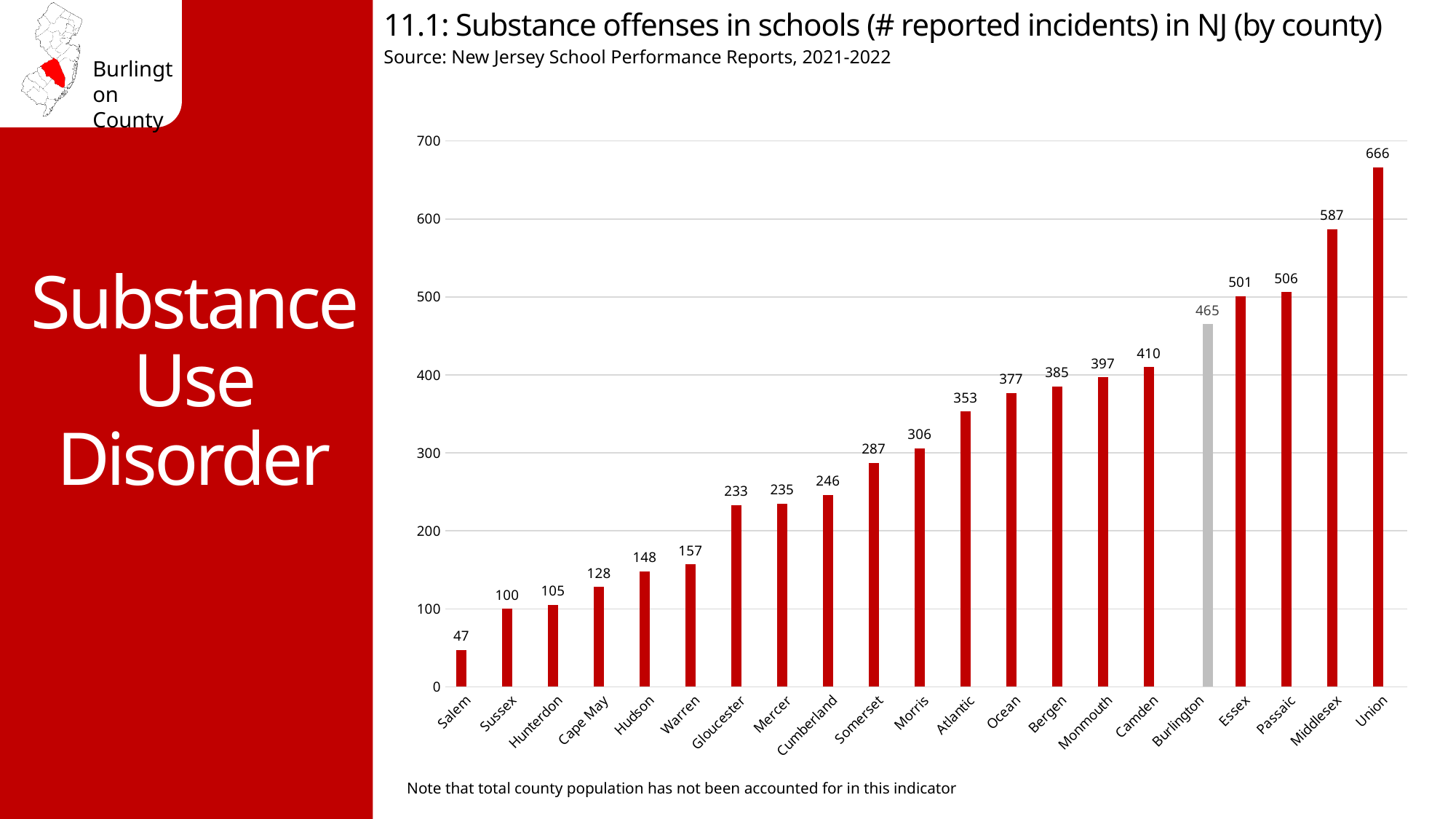
What is the difference between the values for Sussex and Hunterdon? 5 How many counties are shown on the x axis of the chart? 21 What is the difference between the values for Union and Burlington? 201 Which county has the highest number of reported substance offenses in schools? Union What is the value shown for Middlesex County? 587 Is the value for Camden greater or less than 400? greater What kind of chart is used on this slide? Bar chart Which county has the lowest number of reported substance offenses in schools? Salem Do the values rise or fall moving from left to right along the x axis? Rise How many reported substance offense incidents in schools does the chart show for Burlington County? 465 Which county's bar is coloured grey instead of red? Burlington Which county has a higher value, Essex or Passaic? Passaic